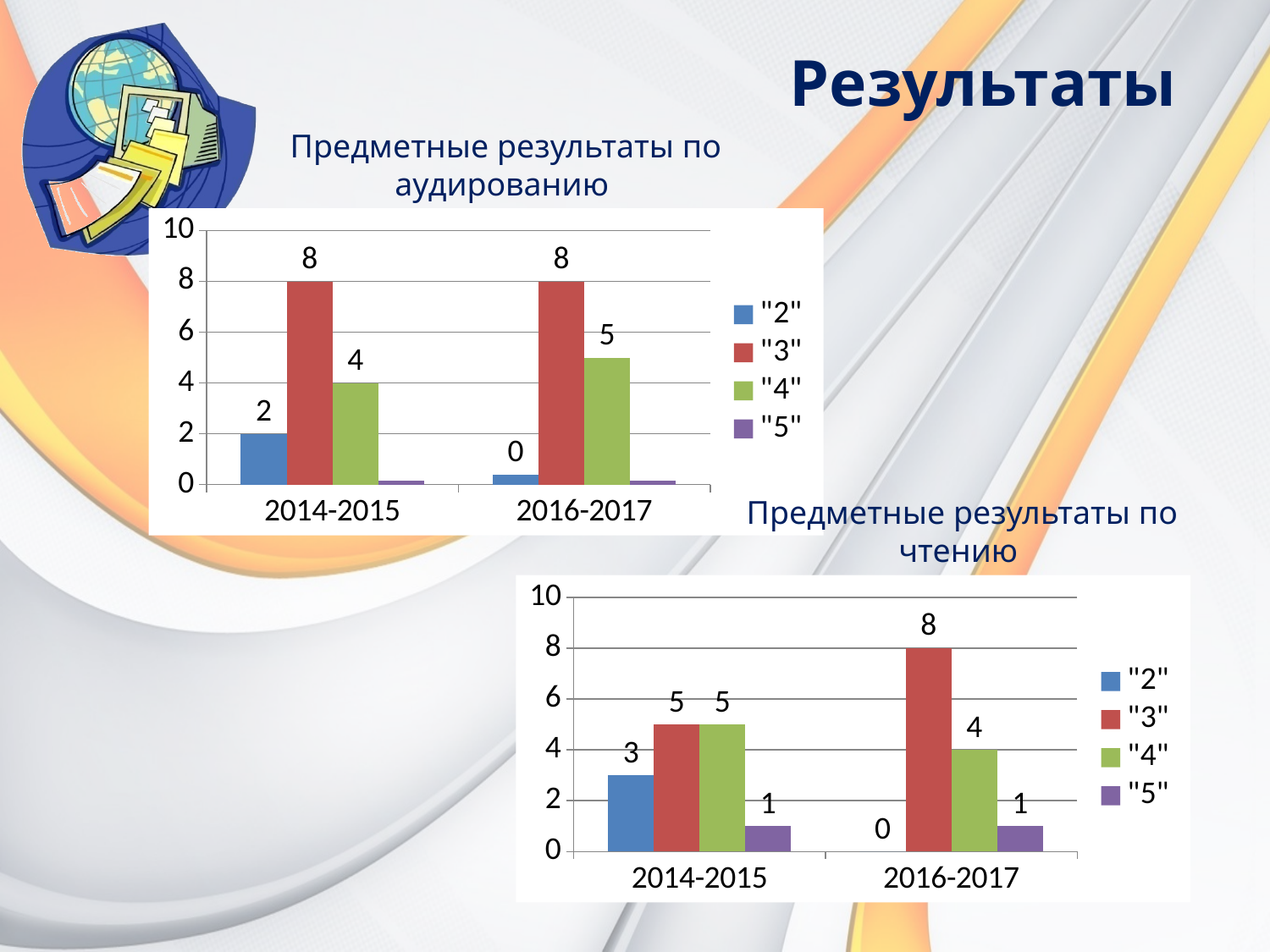
What type of chart is 'Предметные результаты по чтению'? Bar chart In the chart 'Предметные результаты по чтению', what is the value for "3" in 2016-2017? 8 In the chart 'Предметные результаты по чтению', what is the value for "2" in 2014-2015? 3 In the chart 'Предметные результаты по аудированию', what is the value for "2" in 2014-2015? 2 In the chart 'Предметные результаты по чтению', what is the difference between the "3" and "4" values in 2016-2017? 4 In the chart 'Предметные результаты по аудированию', which series has the highest value in 2014-2015? "3" In the chart 'Предметные результаты по аудированию', what is the difference between the "4" values for 2016-2017 and 2014-2015? 1 In the chart 'Предметные результаты по аудированию', what is the value for "4" in 2016-2017? 5 How many series does the legend of the chart 'Предметные результаты по аудированию' list? 4 In the chart 'Предметные результаты по чтению', which is larger: the "3" value in 2014-2015 or in 2016-2017? 2016-2017 In the chart 'Предметные результаты по аудированию', what is the value for "3" in 2014-2015? 8 In the chart 'Предметные результаты по чтению', what is the value for "5" in 2016-2017? 1